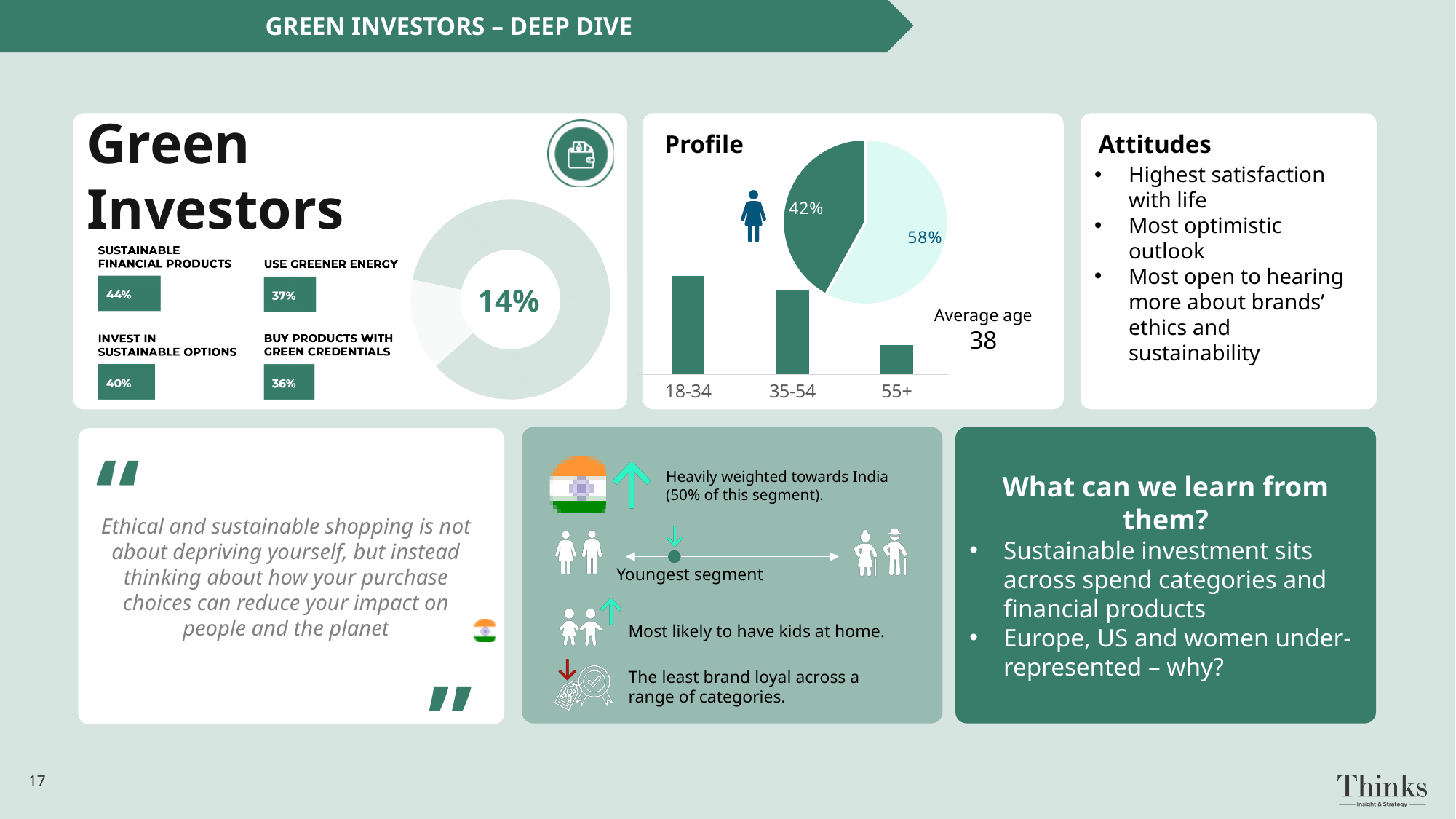
How many age groups are shown in the Profile bar chart? 3 In the Profile pie chart, what percentage is shown for the lighter slice? 58% In the Profile pie chart, which slice is larger, the 42% slice or the 58% slice? 58% In the Profile pie chart, what percentage is shown for the darker green slice? 42% In the Profile bar chart of age groups, which age group has the tallest bar? 18-34 In the Profile bar chart, which bar is taller, 35-54 or 55+? 35-54 What percentage is printed in the centre of the donut chart in the Green Investors panel? 14% How many slices does the Profile pie chart have? 2 In the Profile pie chart, what is the difference between the two slices' percentages? 16% Do the bars in the Profile age chart rise or fall from 18-34 to 55+? fall What kind of chart shows the age groups 18-34, 35-54 and 55+ in the Profile panel? bar chart In the Profile bar chart of age groups, which age group has the shortest bar? 55+